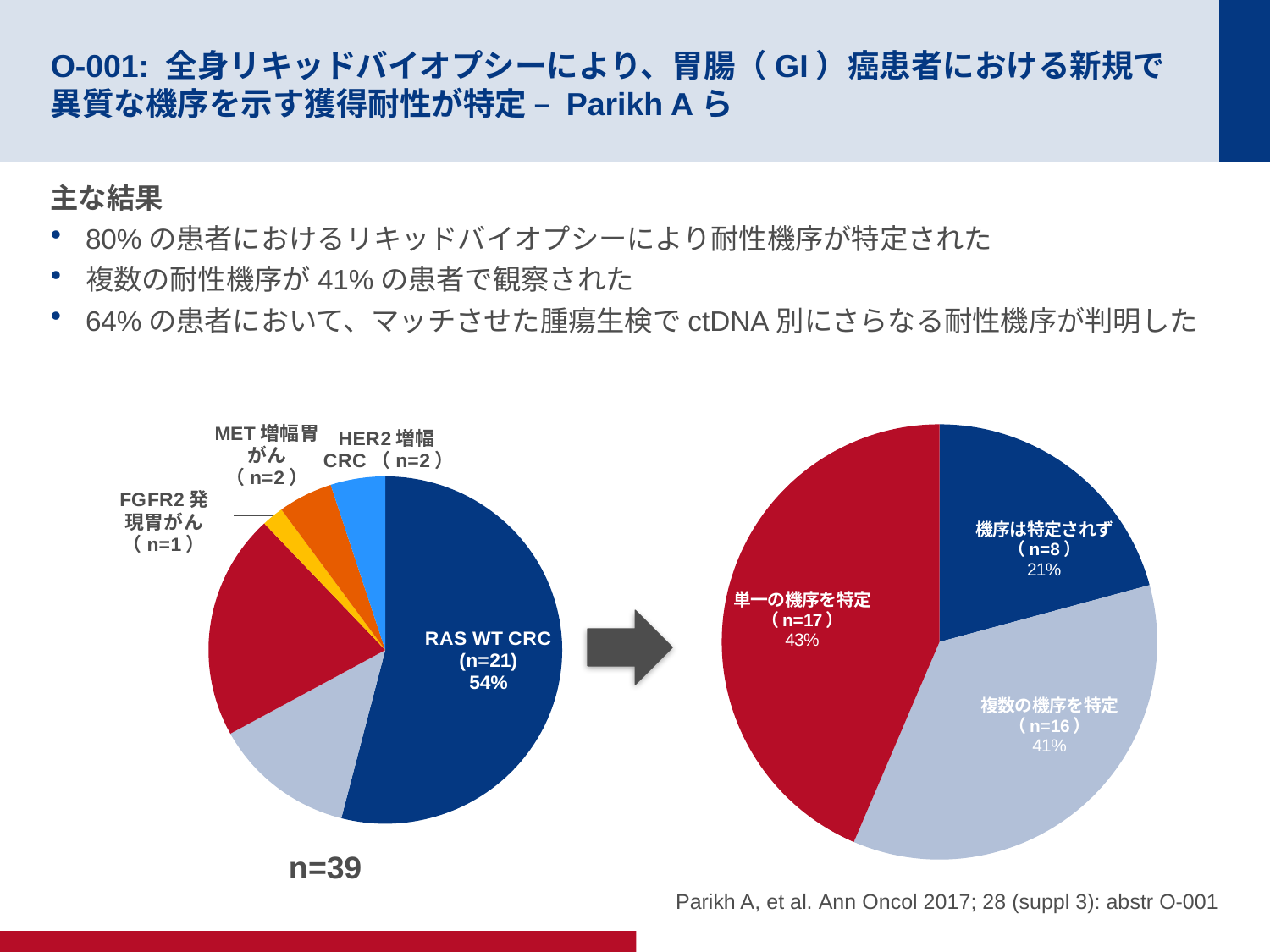
In the right pie chart, which category has the smallest share? 機序は特定されず In the right pie chart, what percentage is shown for 機序は特定されず? 21% In the right pie chart, what percentage is shown for 単一の機序を特定? 43% In the right pie chart, which category has the largest share? 単一の機序を特定 In the left pie chart, what percentage is shown for RAS WT CRC? 54% In the right pie chart, how many slices are there? 3 In the right pie chart, what is the n value for 複数の機序を特定? n=16 In the right pie chart, how many more patients are in 単一の機序を特定 than in 機序は特定されず? 9 What type of chart is used on the right side of the slide? Pie chart What is the total n shown below the left pie chart? n=39 In the left pie chart, what is the n value for FGFR2 発現胃がん? n=1 In the left pie chart, what is the n value for HER2 増幅 CRC? n=2